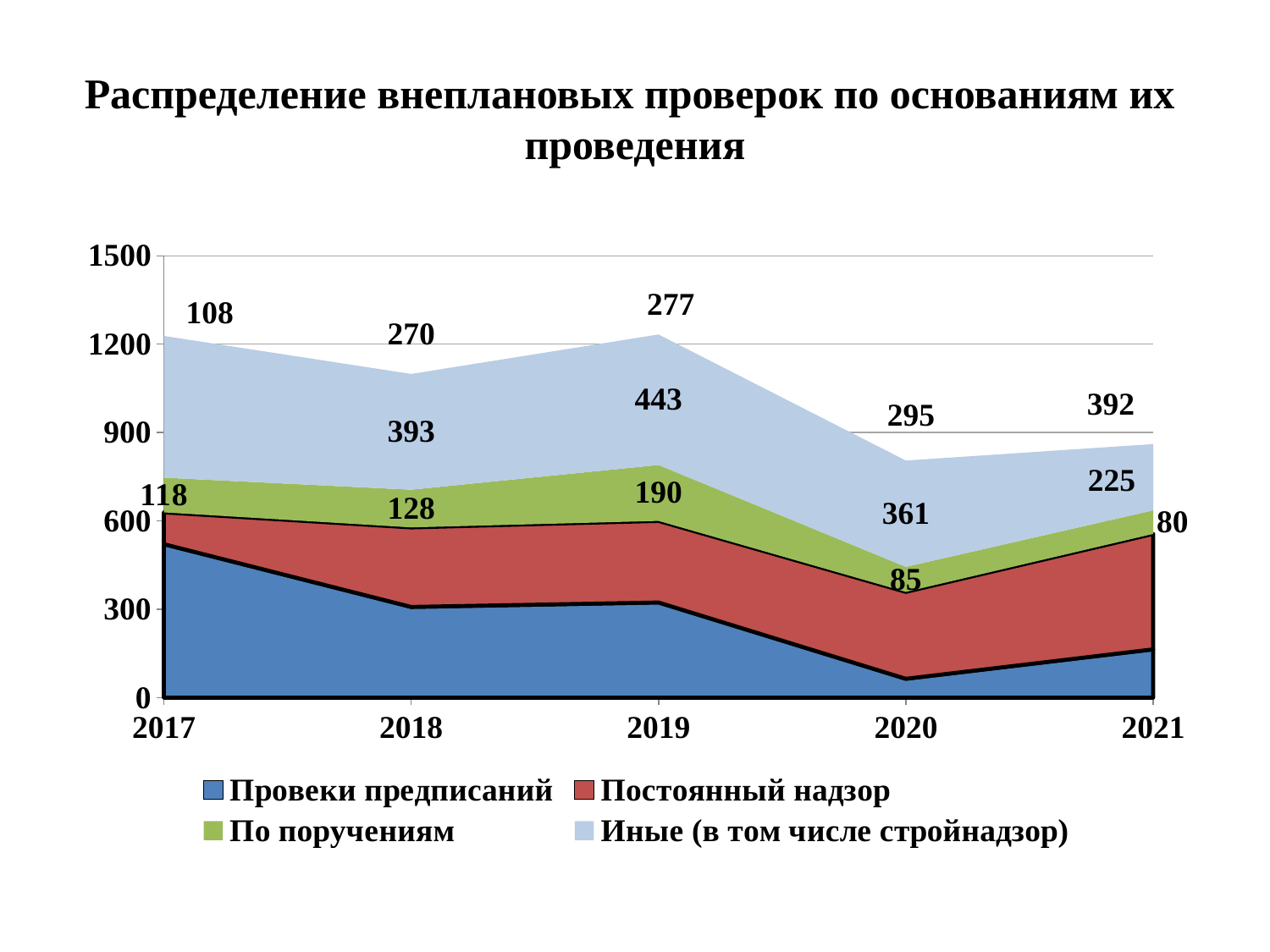
Is the value for Провеки предписаний in 2017 greater or less than 300? greater What is the difference between the По поручениям values for 2019 and 2020? 105 Does the Провеки предписаний series rise or fall from 2017 to 2020? fall In which year is the value for По поручениям highest? 2019 What is the value for Иные (в том числе стройнадзор) in 2019? 443 What is the value for По поручениям in 2019? 190 In which year is the value for По поручениям lowest? 2021 What is the value for По поручениям in 2021? 80 How many years are shown on the x axis? 5 What kind of chart is shown on the slide? stacked area chart How many series does the legend list? 4 What is the value for Иные (в том числе стройнадзор) in 2020? 361